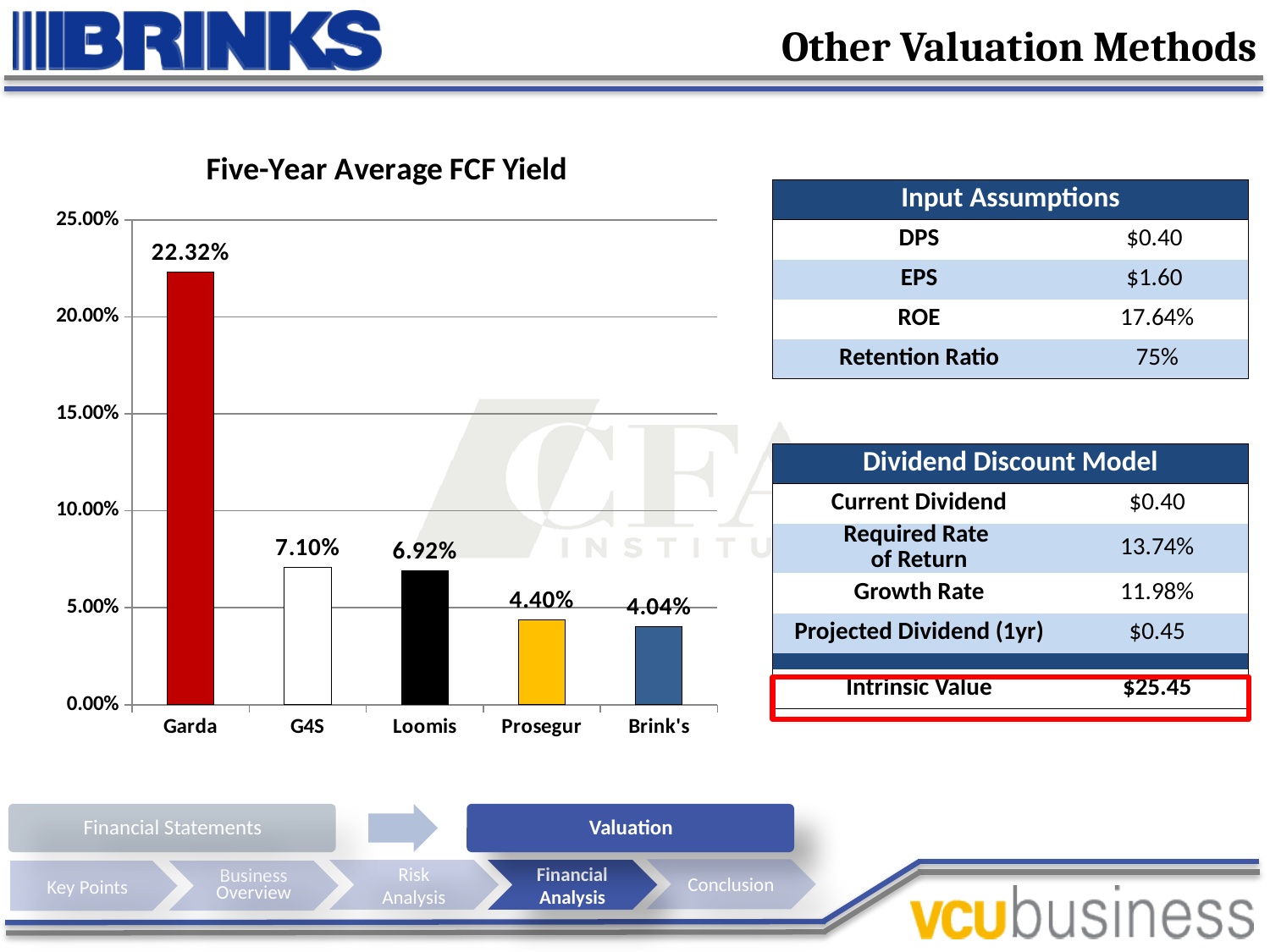
What is the five-year average FCF yield for Garda? 22.32% How many companies are shown in the Five-Year Average FCF Yield chart? 5 What is the title of the chart on the slide? Five-Year Average FCF Yield Is the FCF yield for Prosegur greater or less than 5.00%? less What is the five-year average FCF yield for Brink's? 4.04% Which company has the lowest five-year average FCF yield? Brink's What is the difference between the FCF yields of Prosegur and Brink's? 0.36% What is the five-year average FCF yield for Loomis? 6.92% Which has a higher five-year average FCF yield, G4S or Loomis? G4S What type of chart is used to show the Five-Year Average FCF Yield? bar chart Which company has the highest five-year average FCF yield? Garda What is the difference between the FCF yields of Garda and G4S? 15.22%